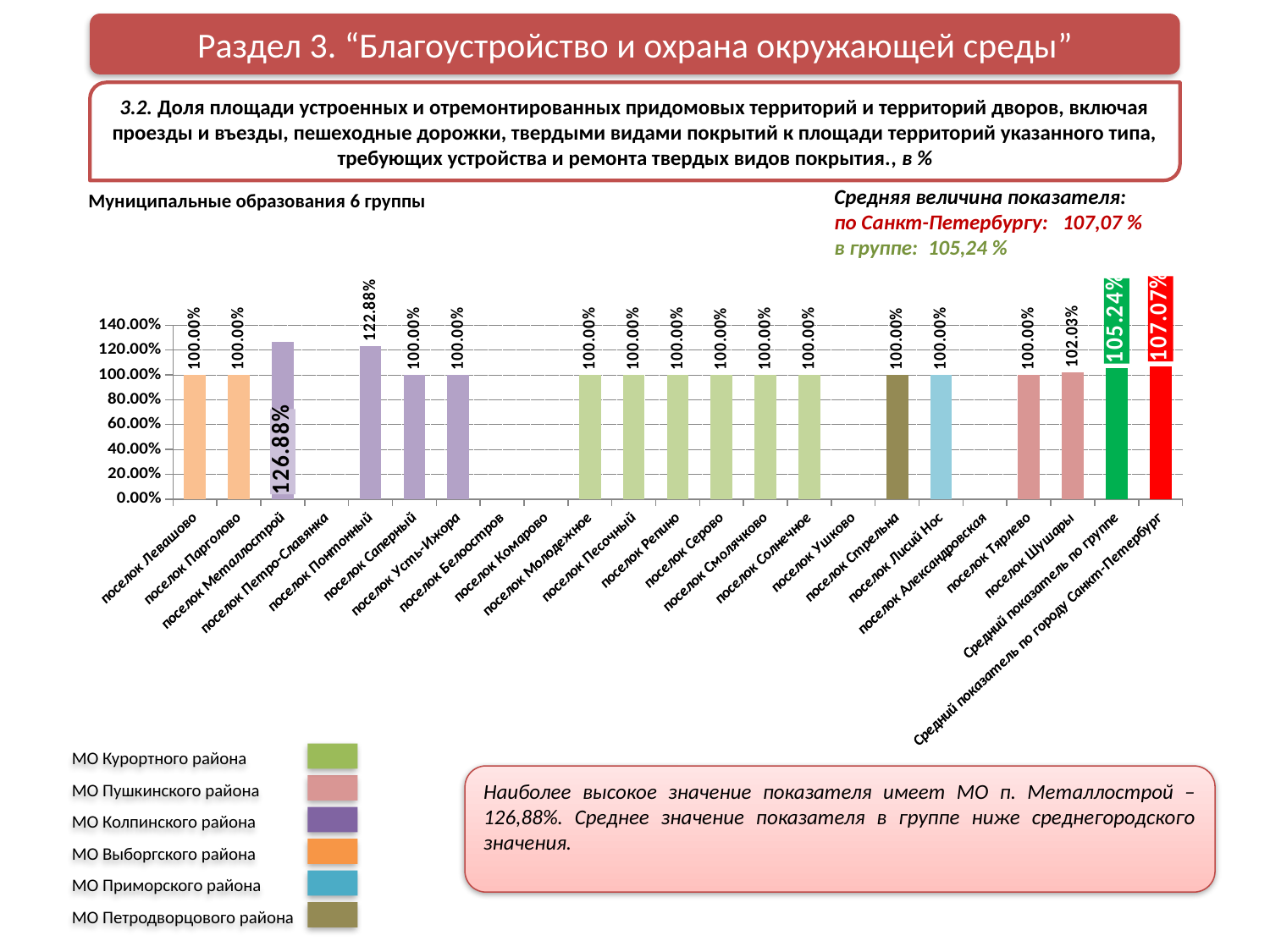
Which category has the highest value on the chart? поселок Металлострой What is the value shown for Средний показатель по городу Санкт-Петербург? 107.07% Is the value for поселок Металлострой greater or less than 120.00%? greater How many categories are listed along the x axis of the chart? 23 What kind of chart is shown on the slide? bar chart What is the value for поселок Шушары? 102.03% Which is larger, the value for поселок Шушары or the value for поселок Понтонный? поселок Понтонный What is the value shown for Средний показатель по группе? 105.24% What is the difference between the city average (Средний показатель по городу Санкт-Петербург) and the group average (Средний показатель по группе)? 1.83% What is the value for поселок Понтонный? 122.88% What is the value for поселок Металлострой? 126.88% What is the difference between the values for поселок Металлострой and поселок Понтонный? 4.00%